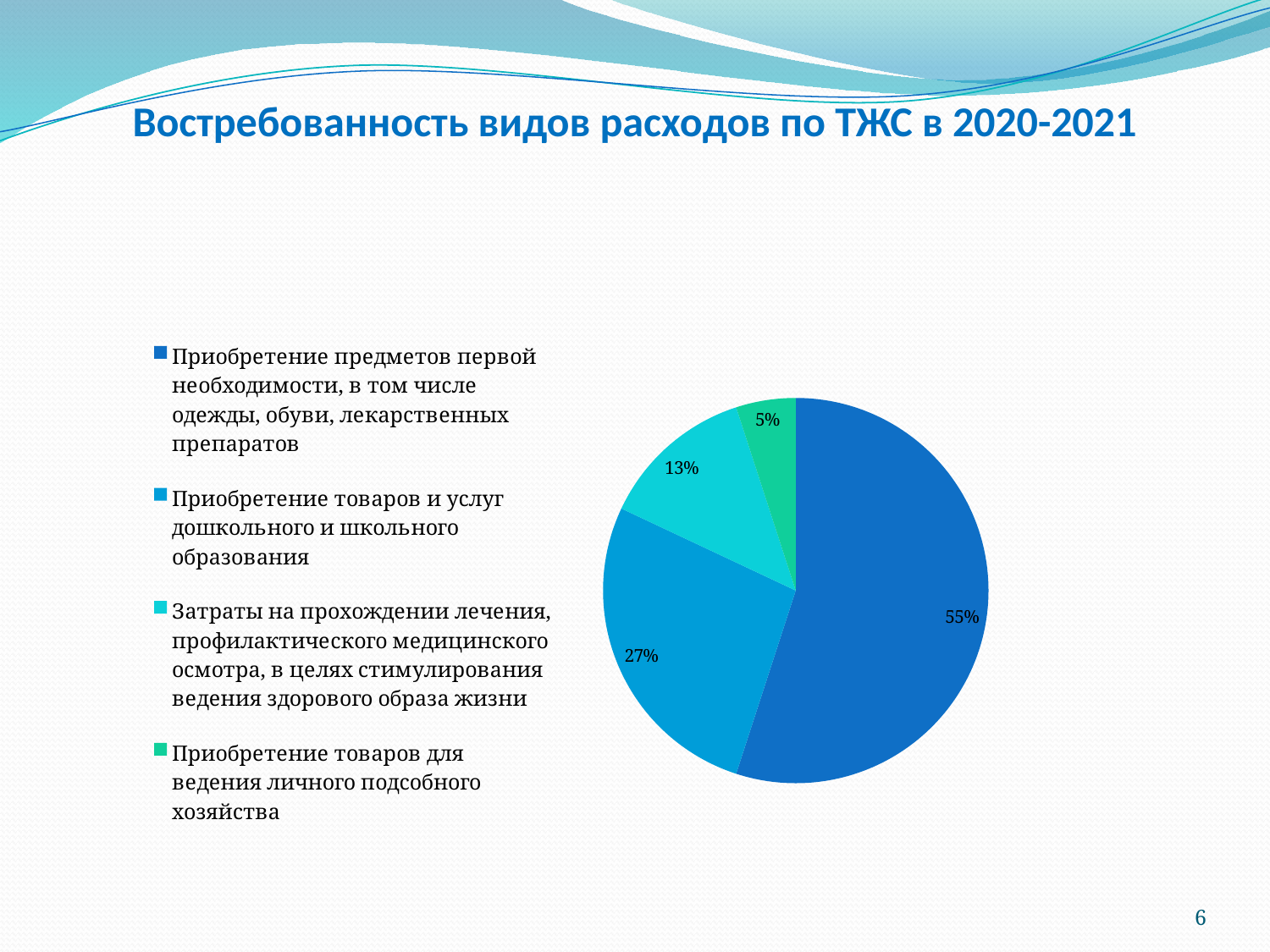
How many entries does the legend list? 4 What is the difference in percentage points between the largest slice (55%) and the slice for school and preschool education goods and services (27%)? 28 What share of the pie is labelled for 'Приобретение товаров для ведения личного подсобного хозяйства'? 5% What is the title of the slide containing the pie chart? Востребованность видов расходов по ТЖС в 2020-2021 What share of the pie is labelled for 'Приобретение предметов первой необходимости, в том числе одежды, обуви, лекарственных препаратов'? 55% What share of the pie is labelled for 'Затраты на прохождении лечения, профилактического медицинского осмотра, в целях стимулирования ведения здорового образа жизни'? 13% What type of chart is shown on the slide? Pie chart Which category has the largest slice of the pie? Приобретение предметов первой необходимости, в том числе одежды, обуви, лекарственных препаратов Which category has the smallest slice of the pie? Приобретение товаров для ведения личного подсобного хозяйства Which is larger: the slice for 'Затраты на прохождении лечения...' or the slice for 'Приобретение товаров для ведения личного подсобного хозяйства'? Затраты на прохождении лечения... How many slices does the pie chart have? 4